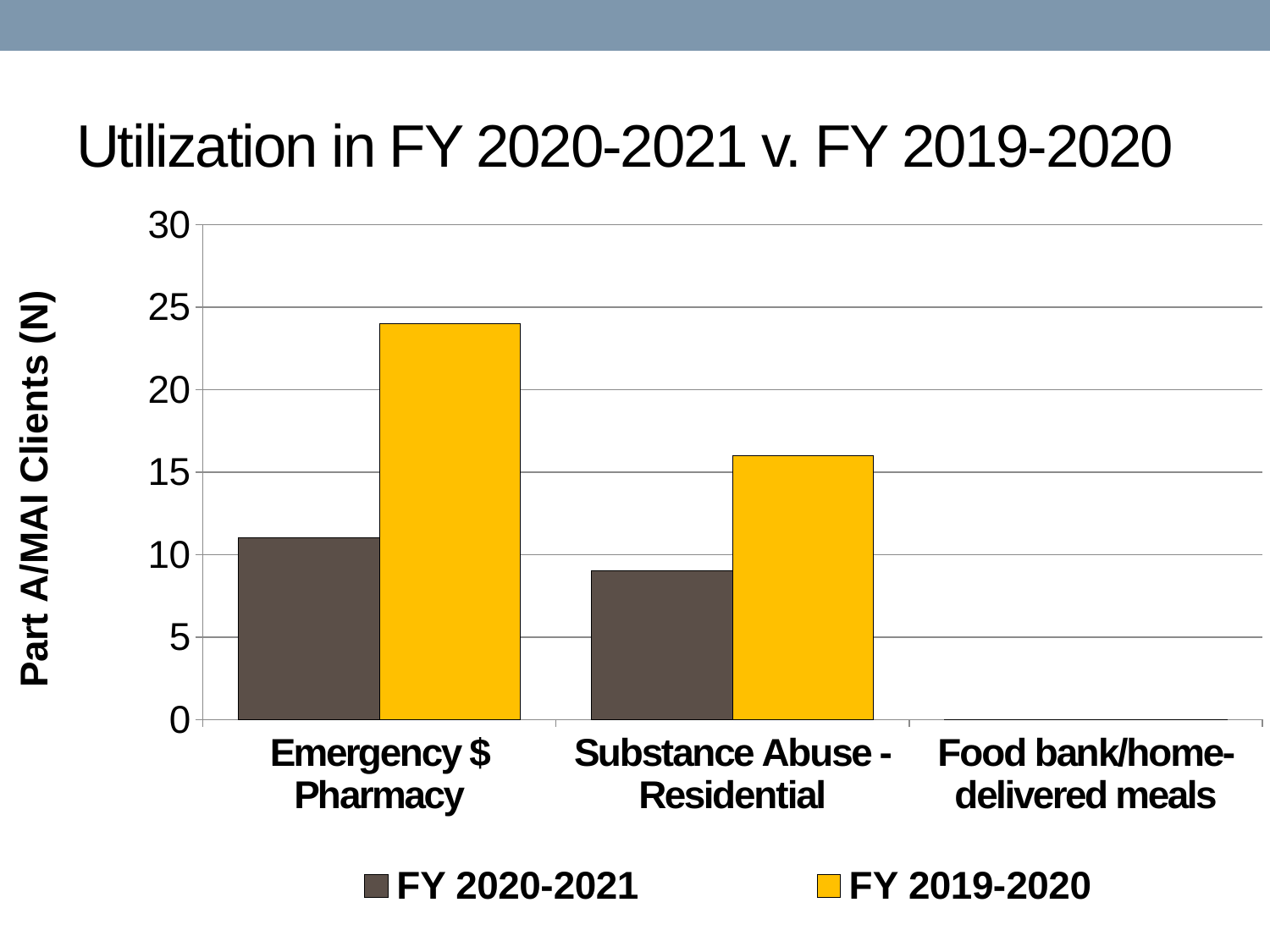
What is the label on the vertical axis? Part A/MAI Clients (N) How many series does the legend list? 2 Is the FY 2019-2020 value for Substance Abuse - Residential greater or less than 15? greater How many categories are shown on the x axis? 3 For Emergency $ Pharmacy, which series has the larger value, FY 2020-2021 or FY 2019-2020? FY 2019-2020 Which category has the lowest FY 2020-2021 value? Food bank/home-delivered meals Is the FY 2019-2020 value for Emergency $ Pharmacy greater or less than 20? greater What is the title of the chart? Utilization in FY 2020-2021 v. FY 2019-2020 Is the FY 2020-2021 value for Emergency $ Pharmacy greater or less than 15? less What kind of chart is shown on the slide? bar chart Which category has the highest FY 2019-2020 value? Emergency $ Pharmacy